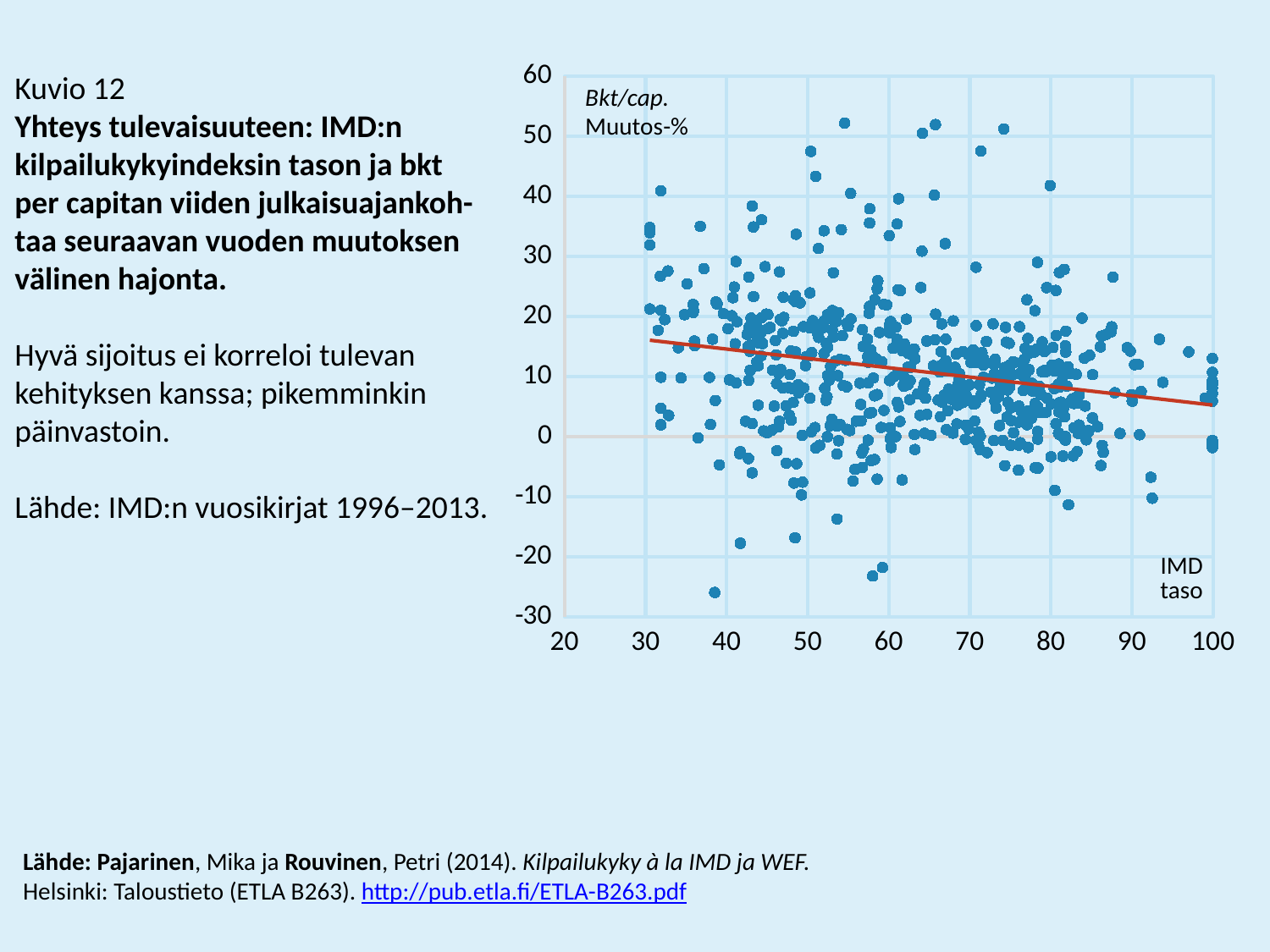
What is the highest value shown on the x axis of the chart? 100 Is the lowest plotted point in the chart greater or less than -20? less What is the figure number given for the chart on the slide? Kuvio 12 What kind of chart is shown on the slide? scatter plot Is the value of the red trend line at IMD taso 100 greater or less than 10? less Does the red trend line rise or fall as the IMD taso increases along the x axis? fall What is the label of the y axis of the chart? Bkt/cap. Muutos-% What is the lowest value shown on the x axis of the chart? 20 What is the lowest value shown on the y axis of the chart? -30 Is the value of the red trend line at IMD taso 30 greater or less than 10? greater What is the label of the x axis of the chart? IMD taso What is the highest value shown on the y axis of the chart? 60